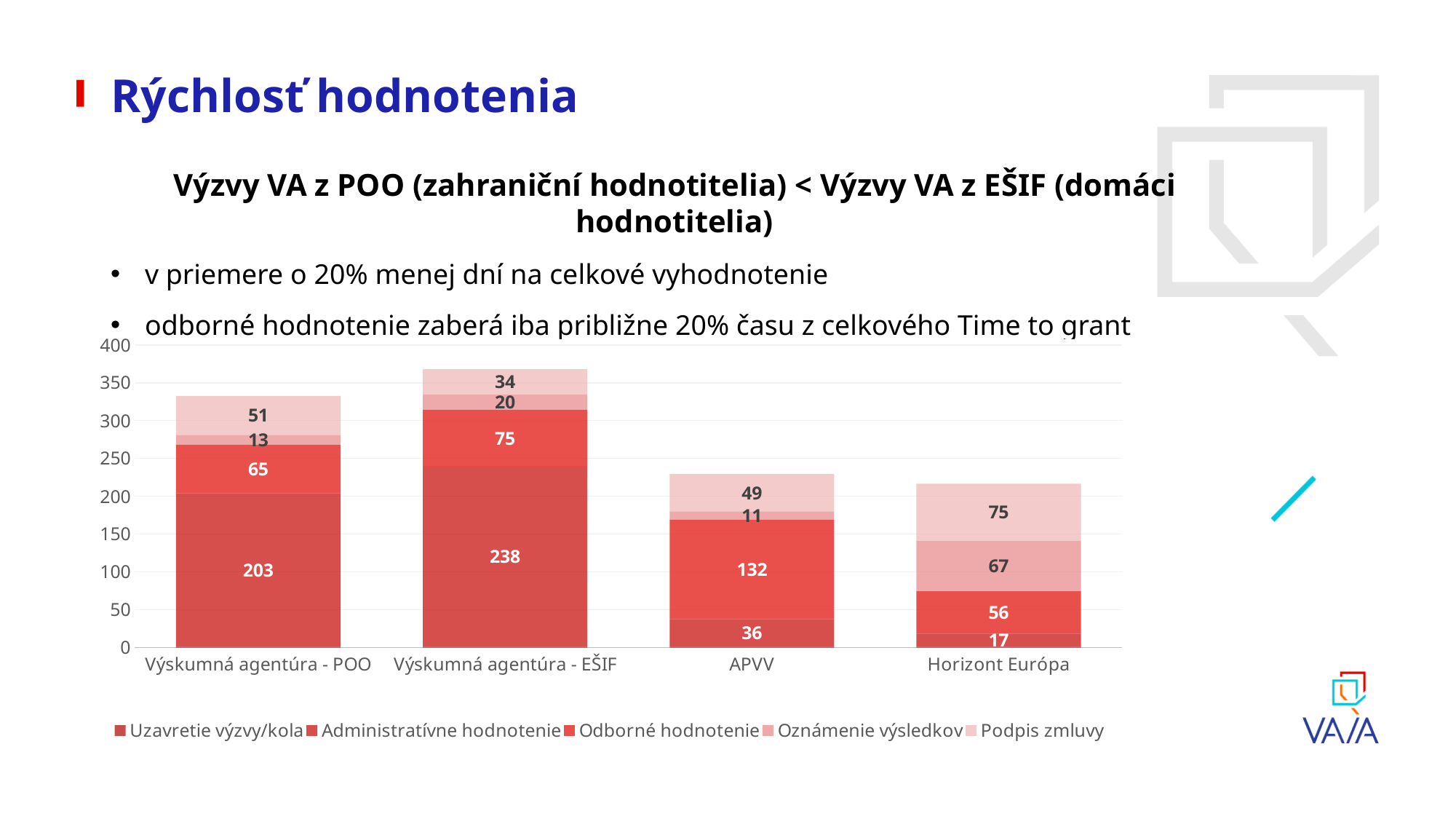
What kind of chart is shown on the slide? Stacked bar chart Is the total height of the Horizont Európa bar greater or less than 250? less What is the difference between the bottom segment of Výskumná agentúra - EŠIF (238) and the bottom segment of Výskumná agentúra - POO (203)? 35 What is the value of the topmost segment in the Horizont Európa bar? 75 What is the value of the largest segment in the APVV bar? 132 How many series does the chart legend list? 5 Which category has the tallest stacked bar overall? Výskumná agentúra - EŠIF How many categories are shown on the x axis of the chart? 4